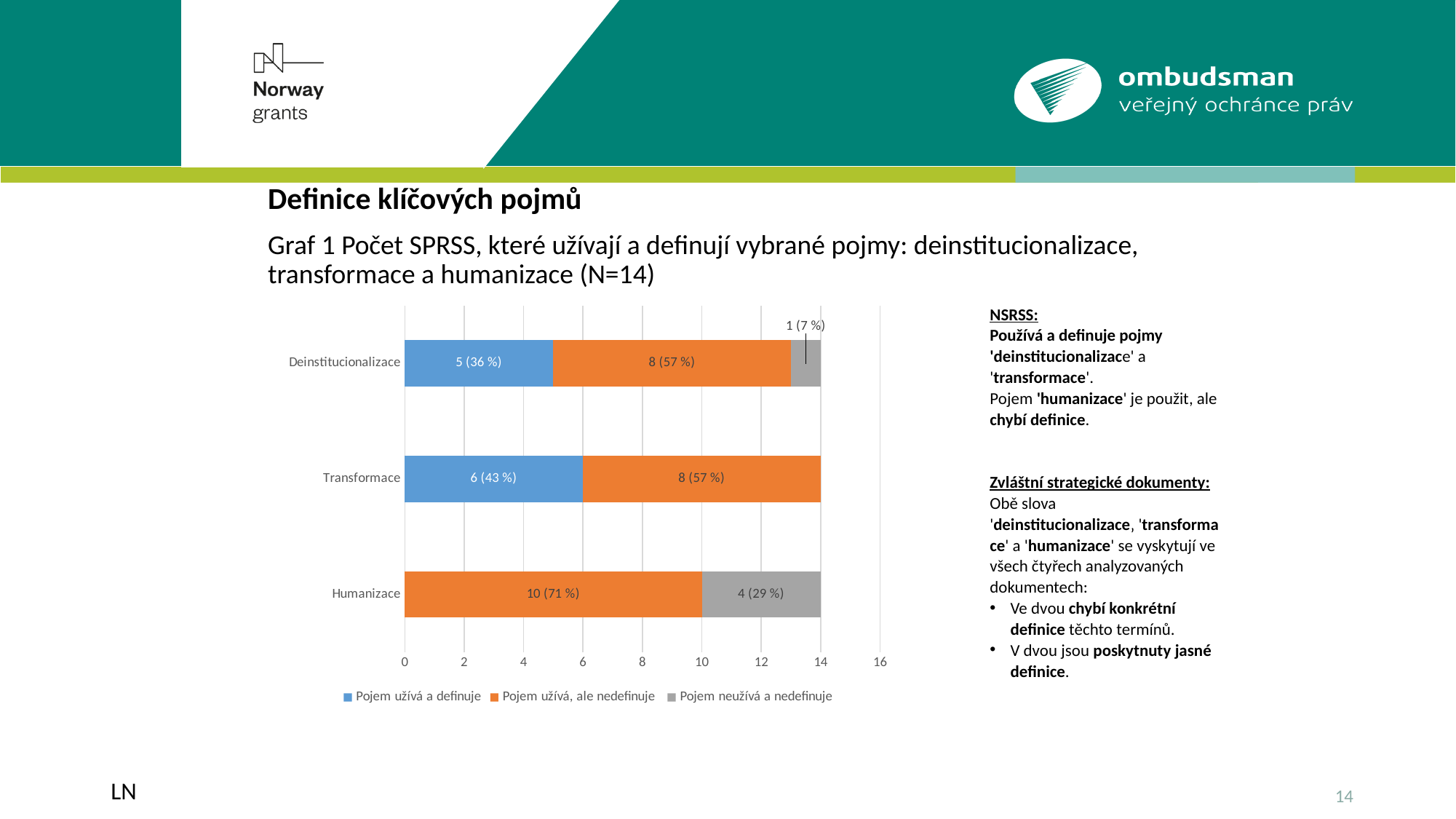
Which category has the highest value for 'Pojem užívá, ale nedefinuje'? Humanizace What is the total of the stacked bar for Transformace? 14 What is the value of 'Pojem užívá a definuje' for Deinstitucionalizace? 5 (36 %) What is the value of 'Pojem užívá a definuje' for Transformace? 6 (43 %) How many categories are shown on the chart? 3 Which is larger: 'Pojem užívá a definuje' for Transformace or for Deinstitucionalizace? Transformace How many series does the chart legend list? 3 What is the difference between the 'Pojem neužívá a nedefinuje' values for Humanizace and Deinstitucionalizace? 3 Which category has the highest value for 'Pojem neužívá a nedefinuje'? Humanizace What type of chart is shown on the slide? Stacked bar chart What is the value of 'Pojem užívá, ale nedefinuje' for Humanizace? 10 (71 %) What is the value of 'Pojem neužívá a nedefinuje' for Deinstitucionalizace? 1 (7 %)